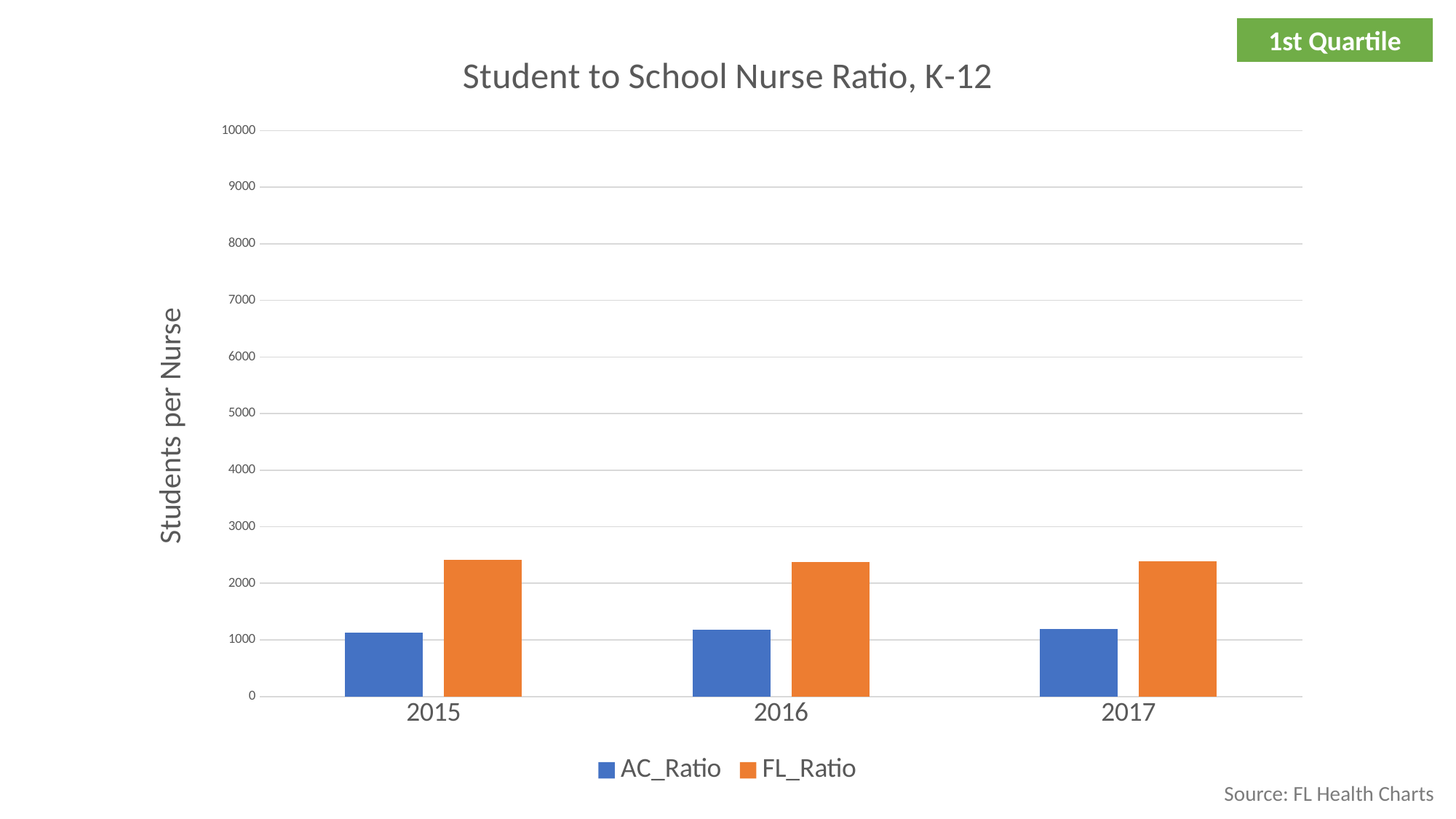
How many series does the legend list? 2 What type of chart is shown on the slide? bar chart Is the FL_Ratio value for 2017 greater or less than 3000? less Which series is shown in orange? FL_Ratio How many years are shown on the x axis? 3 Is the FL_Ratio value for 2016 greater or less than 2000? greater What is the title of the chart? Student to School Nurse Ratio, K-12 Is the AC_Ratio value for 2016 greater or less than 2000? less Which series is larger in 2017, AC_Ratio or FL_Ratio? FL_Ratio Which series is larger in 2015, AC_Ratio or FL_Ratio? FL_Ratio What is the label on the vertical axis? Students per Nurse